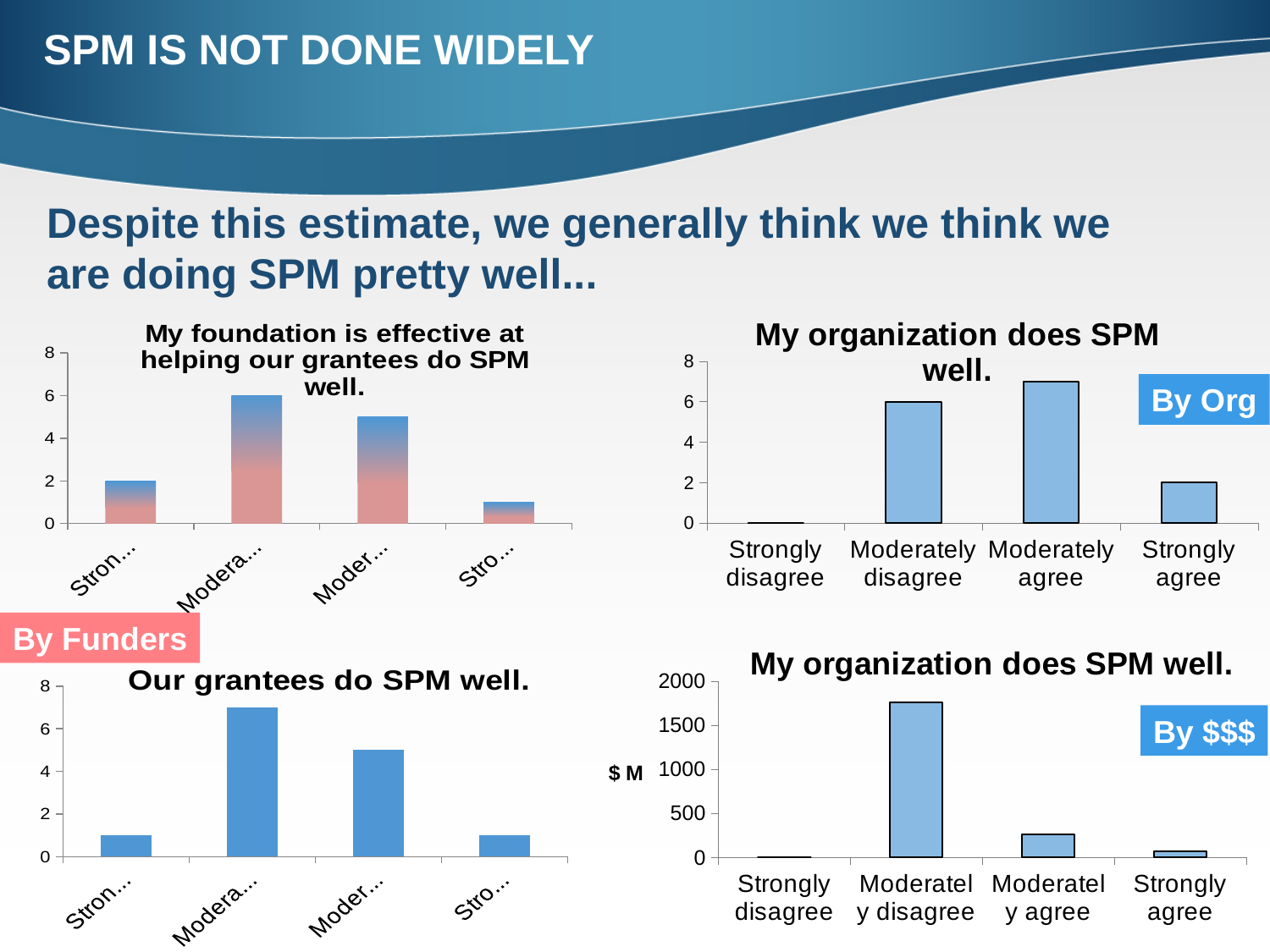
In the top-right chart (By Org), which category has the highest value? Moderately agree In the bottom-right chart (By $$$), is the value for Moderately disagree greater or less than 1500? greater In the bottom-right chart (By $$$), which category has the highest value? Moderately disagree In the bottom-right chart (By $$$), is the value for Moderately agree greater or less than 500? less In the top-right chart (By Org), what is the value for Strongly agree? 2 What kind of chart is the bottom-right chart (By $$$)? bar chart In the top-right chart (By Org), is the value for Moderately agree greater or less than 6? greater In the top-right chart (By Org), how many categories are shown on the x axis? 4 In the bottom-right chart (By $$$), which is larger: the value for Moderately agree or the value for Strongly agree? Moderately agree In the top-left chart titled "My foundation is effective at helping our grantees do SPM well.", what is the value of the tallest bar? 6 In the top-right chart titled "My organization does SPM well." (By Org), what is the value for Moderately disagree? 6 In the top-right chart (By Org), which category has the lowest value? Strongly disagree